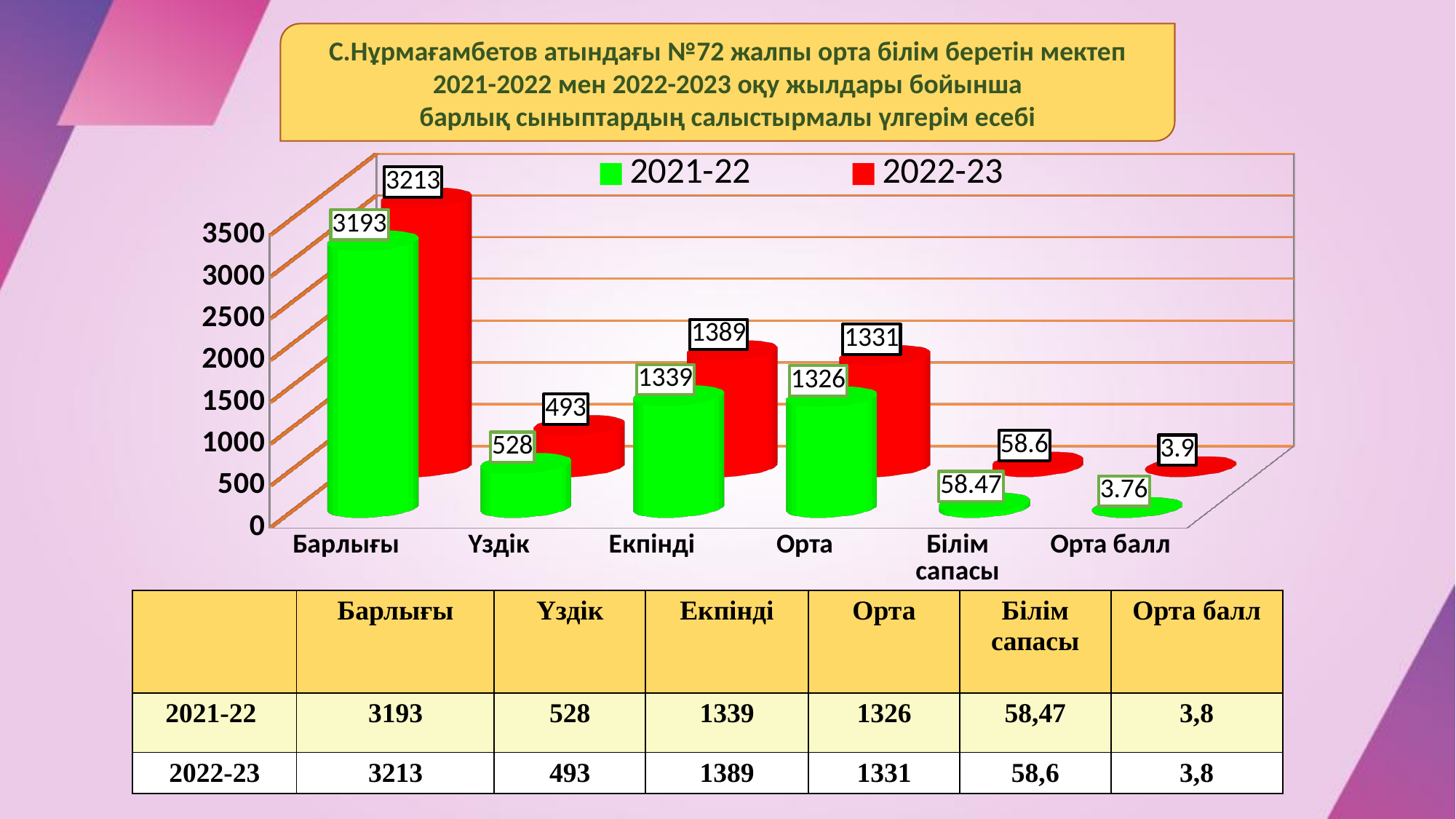
What is the difference between the 2022-23 and 2021-22 values for Екпінді? 50 Which is larger for Үздік: the 2021-22 value or the 2022-23 value? 2021-22 Which category has the highest value in the 2021-22 series? Барлығы What kind of chart is shown on the slide? Bar chart What is the value for Екпінді in the 2022-23 series? 1389 What is the value for Орта балл in the 2021-22 series? 3.76 Which category has the lowest value in the 2022-23 series? Орта балл What is the value for Барлығы in the 2022-23 series? 3213 How many series does the chart legend list? 2 How many categories are shown on the x axis of the chart? 6 What is the value for Үздік in the 2021-22 series? 528 Which colour represents the 2022-23 series in the chart? Red